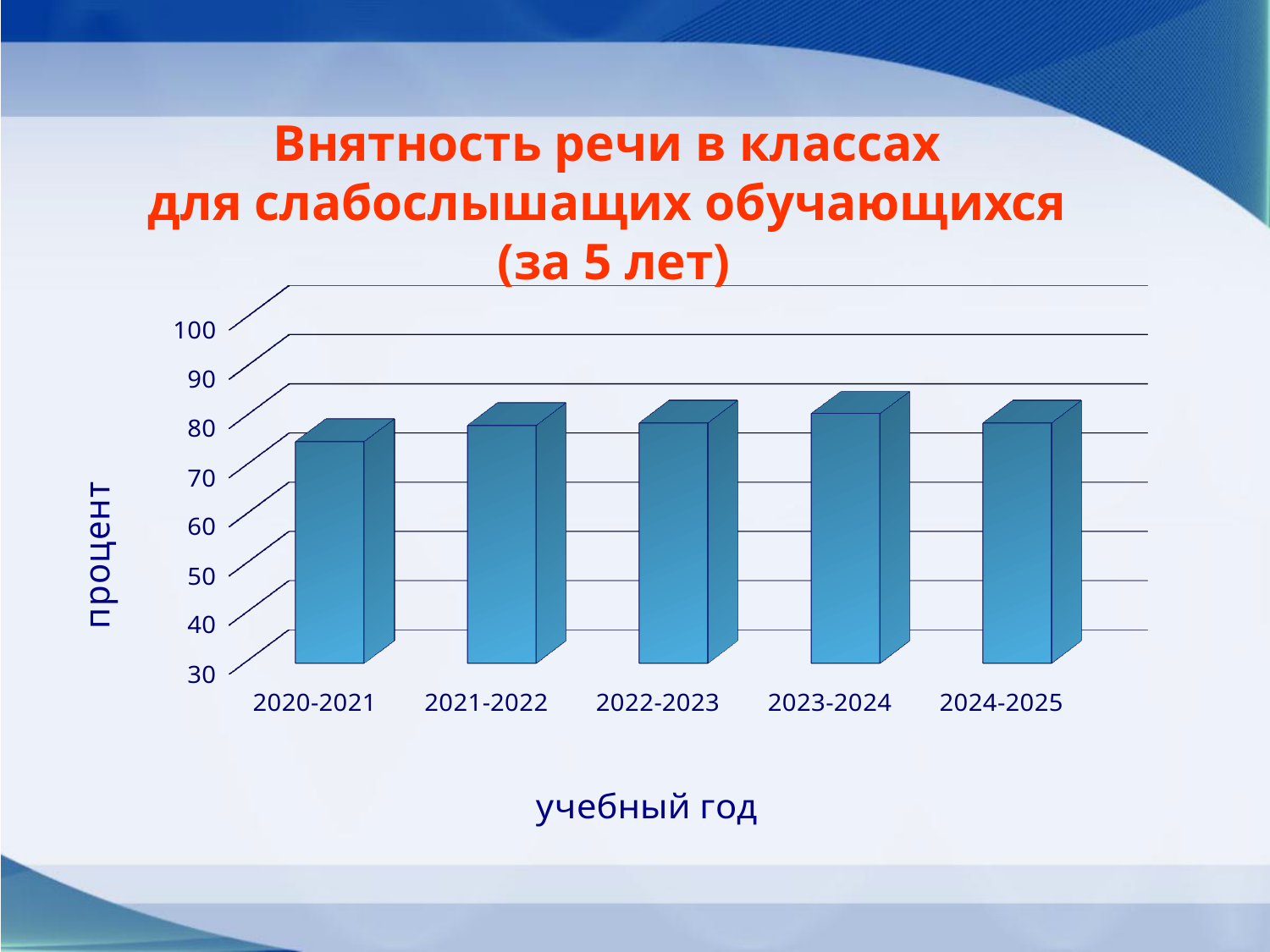
What is the label of the horizontal axis of the chart? учебный год Is the value for 2020-2021 greater or less than 70? greater Does the value rise or fall from 2020-2021 to 2023-2024? rise What is the label of the vertical axis of the chart? процент Is the value for 2023-2024 greater or less than 90? less What kind of chart is shown on the slide? bar chart Is the value for 2024-2025 greater or less than 60? greater Which academic year has the lowest bar on the chart? 2020-2021 How many academic years (categories) are plotted on the chart? 5 Which is larger, the value for 2020-2021 or the value for 2023-2024? 2023-2024 Which academic year has the highest bar on the chart? 2023-2024